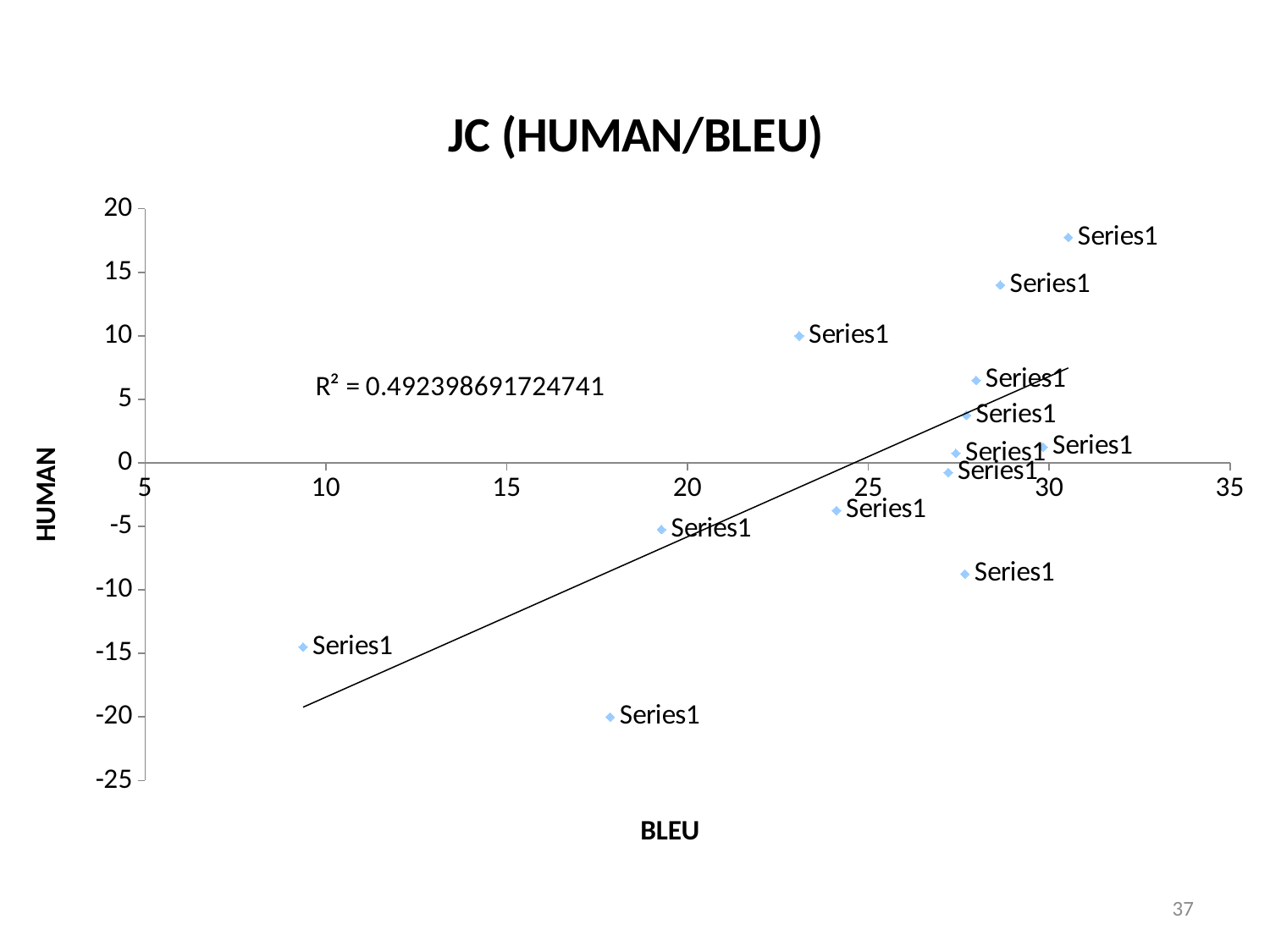
Is the BLEU value of the leftmost point greater or less than 10? less How many data points are plotted on the chart? 13 Is the HUMAN value of the highest point greater or less than 15? greater What is the lowest tick value shown on the HUMAN axis? -25 Is the BLEU value of the rightmost point greater or less than 30? greater What is the label of the horizontal axis? BLEU What kind of chart is shown on the slide? scatter chart What is the highest tick value shown on the BLEU axis? 35 What is the title of the chart? JC (HUMAN/BLEU) Does the trendline rise or fall as BLEU increases? rises What R² value is printed on the chart? R² = 0.492398691724741